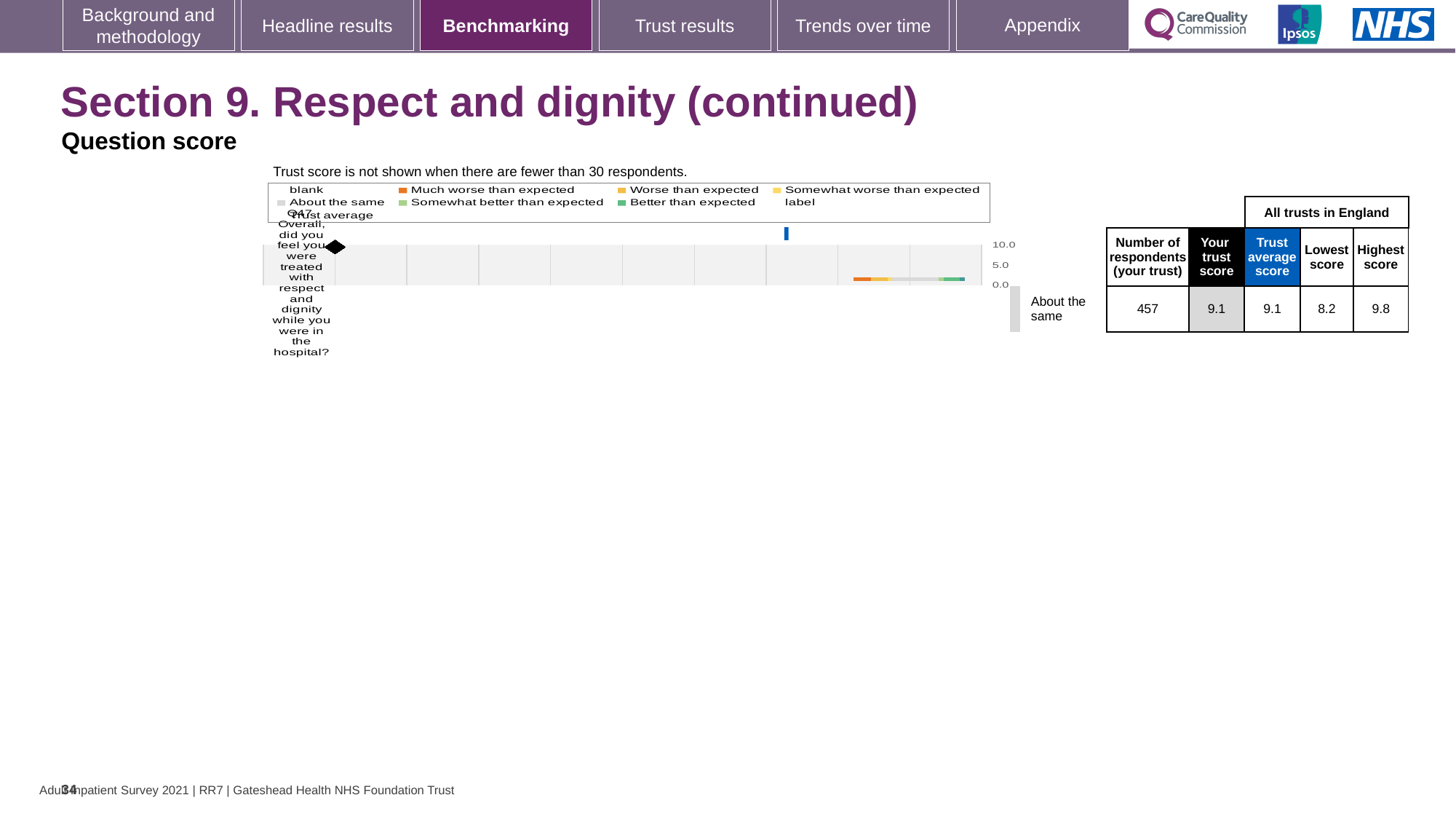
According to the table beside the chart, what is the highest score for Q47 among all trusts in England? 9.8 Is your trust score for Q47 higher than, lower than, or the same as the trust average score? the same According to the table beside the chart, what is your trust score for Q47? 9.1 Which benchmark category label is shown next to the chart for Q47? About the same How many survey questions are plotted in the benchmarking chart? 1 What is the highest tick value shown on the chart's score axis? 10.0 According to the table beside the chart, what is the trust average score for Q47 across all trusts in England? 9.1 According to the table beside the chart, how many respondents answered Q47 for your trust? 457 According to the table beside the chart, what is the lowest score for Q47 among all trusts in England? 8.2 What kind of chart is used to show the Q47 benchmarking result? bar chart What is the difference between the highest score and the lowest score for Q47 in the table beside the chart? 1.6 How much higher is the highest score than your trust score for Q47 in the table beside the chart? 0.7